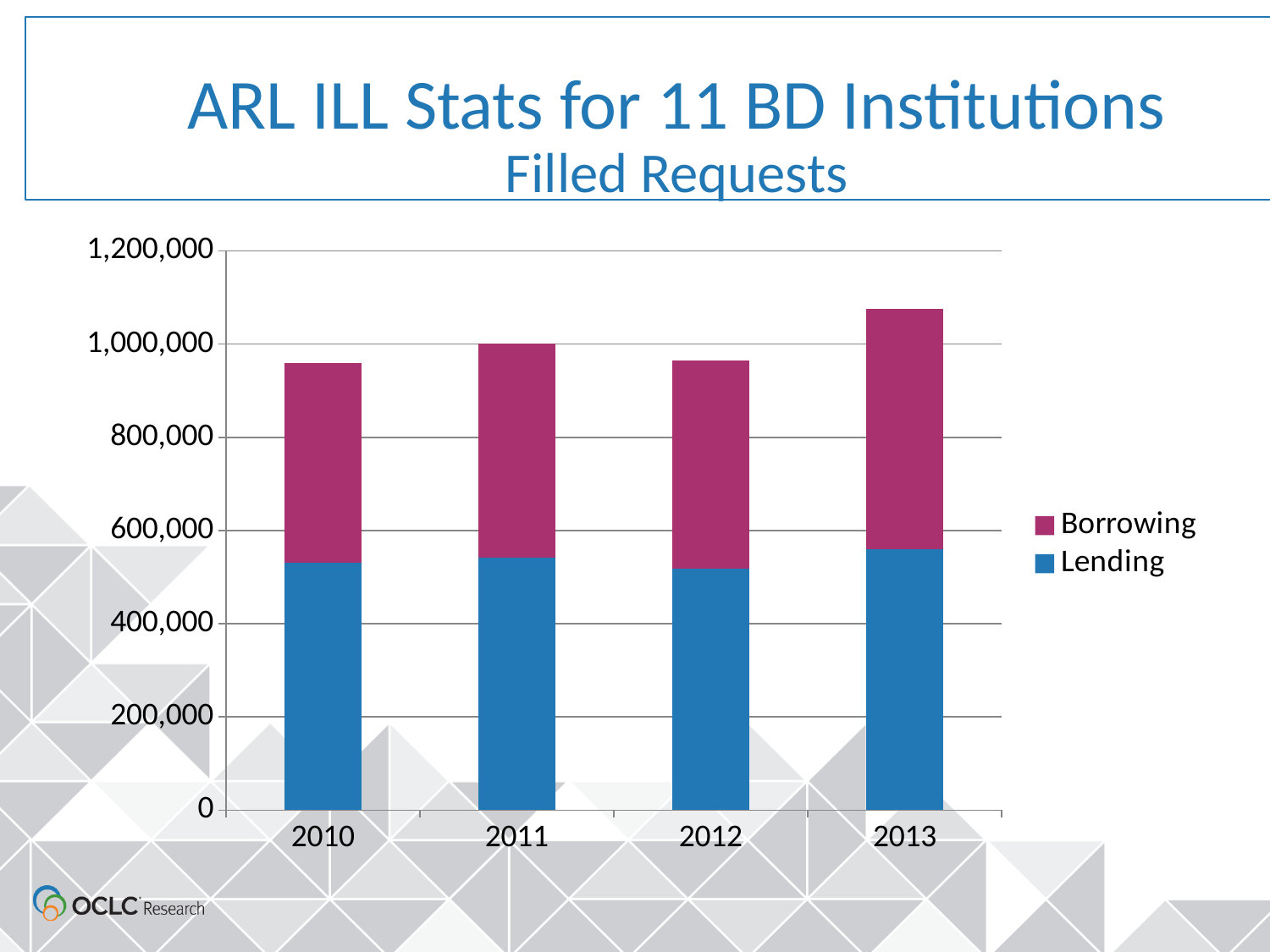
What kind of chart is shown on the slide? Stacked bar chart What is the title of the chart on the slide? ARL ILL Stats for 11 BD Institutions Filled Requests Which year has the larger total of filled requests, 2012 or 2013? 2013 Which year has the larger total of filled requests, 2010 or 2013? 2013 Is the total for 2010 greater or less than 1,000,000? less Is the Lending value for 2013 greater or less than 600,000? less How many years are shown on the x axis of the chart? 4 Which year has the highest total of filled requests? 2013 How many series does the chart's legend list? 2 Is the total for 2013 greater or less than 1,000,000? greater Which series is shown in blue in the chart? Lending